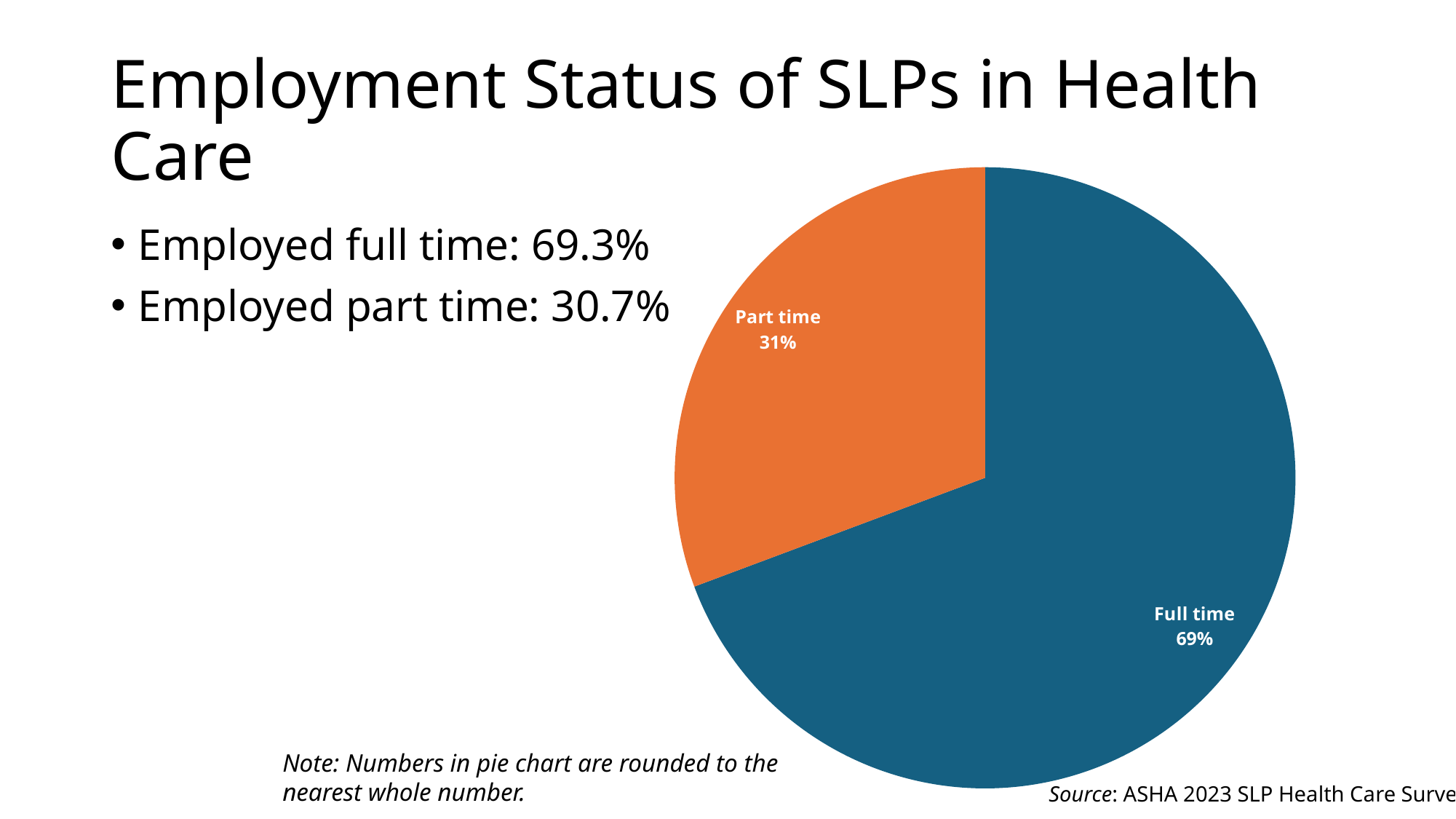
What share of the pie does the Part time slice represent? 31% What percentage does the pie chart show for Part time? 31% Which slice of the pie chart is the largest? Full time What colour is the Full time slice of the pie chart? Blue What is the difference in percentage points between the Full time and Part time slices as labelled on the pie chart? 38 Which is larger in the pie chart, Full time or Part time? Full time What percentage does the pie chart show for Full time? 69% Which slice of the pie chart is the smallest? Part time What kind of chart is shown on the slide? Pie chart What colour is the Part time slice of the pie chart? Orange How many slices does the pie chart have? 2